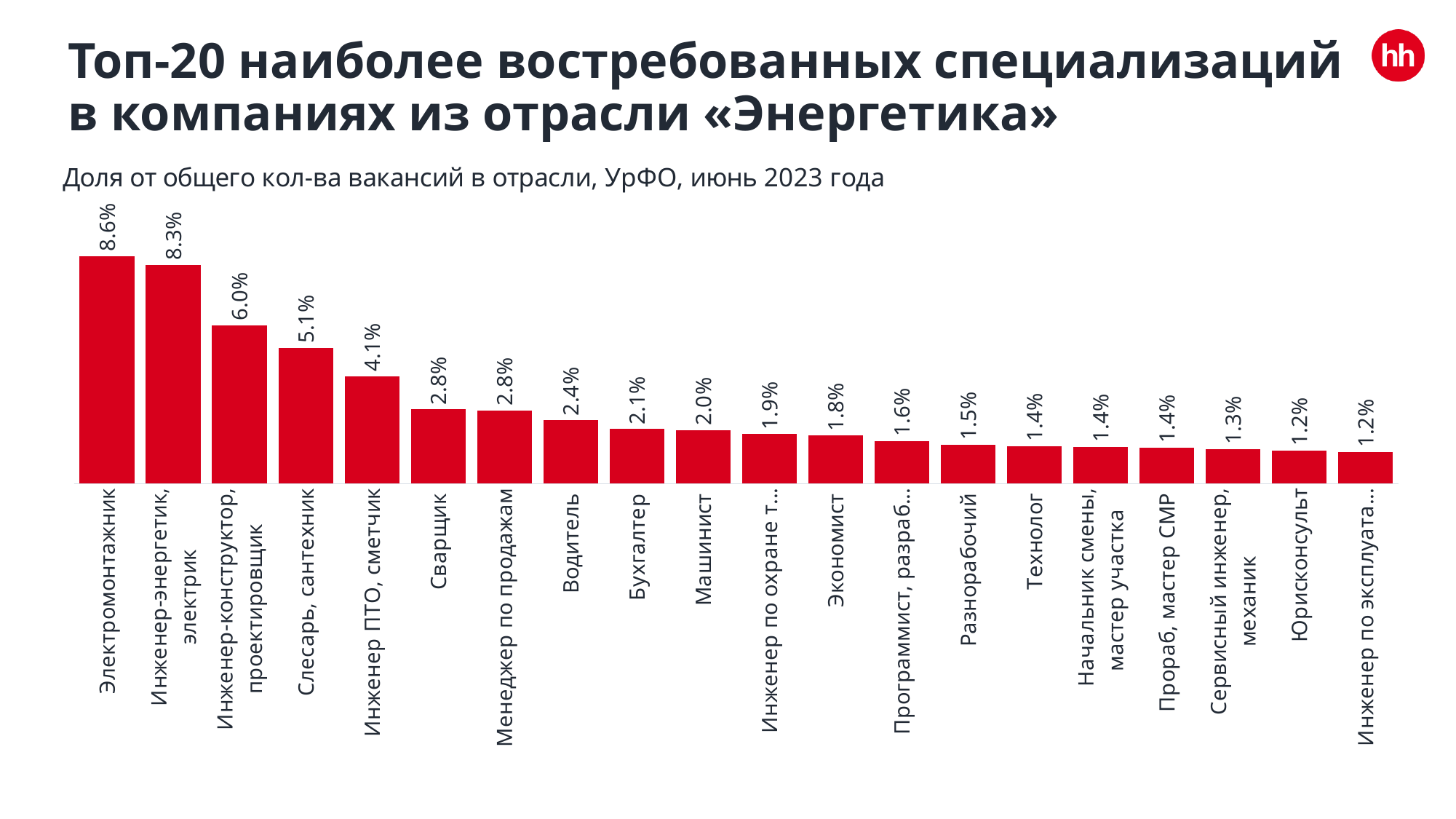
Какая доля вакансий приходится на категорию «Сварщик»? 2.8% На сколько процентных пунктов доля «Электромонтажник» больше доли «Инженер-энергетик, электрик»? 0.3% Что больше: доля «Водитель» или доля «Машинист»? Водитель Какое значение указано для категории «Разнорабочий»? 1.5% Какая специализация имеет наибольшую долю вакансий на диаграмме? Электромонтажник Какое значение указано для категории «Электромонтажник»? 8.6% Какое наименьшее значение показано на диаграмме? 1.2% Как изменяются значения при движении слева направо по оси категорий? Убывают Сколько категорий (специализаций) показано на диаграмме? 20 Какой тип диаграммы используется на слайде? Столбчатая (bar chart) На сколько процентных пунктов доля «Инженер-конструктор, проектировщик» больше доли «Слесарь, сантехник»? 0.9% Какое значение показано для категории «Бухгалтер»? 2.1%